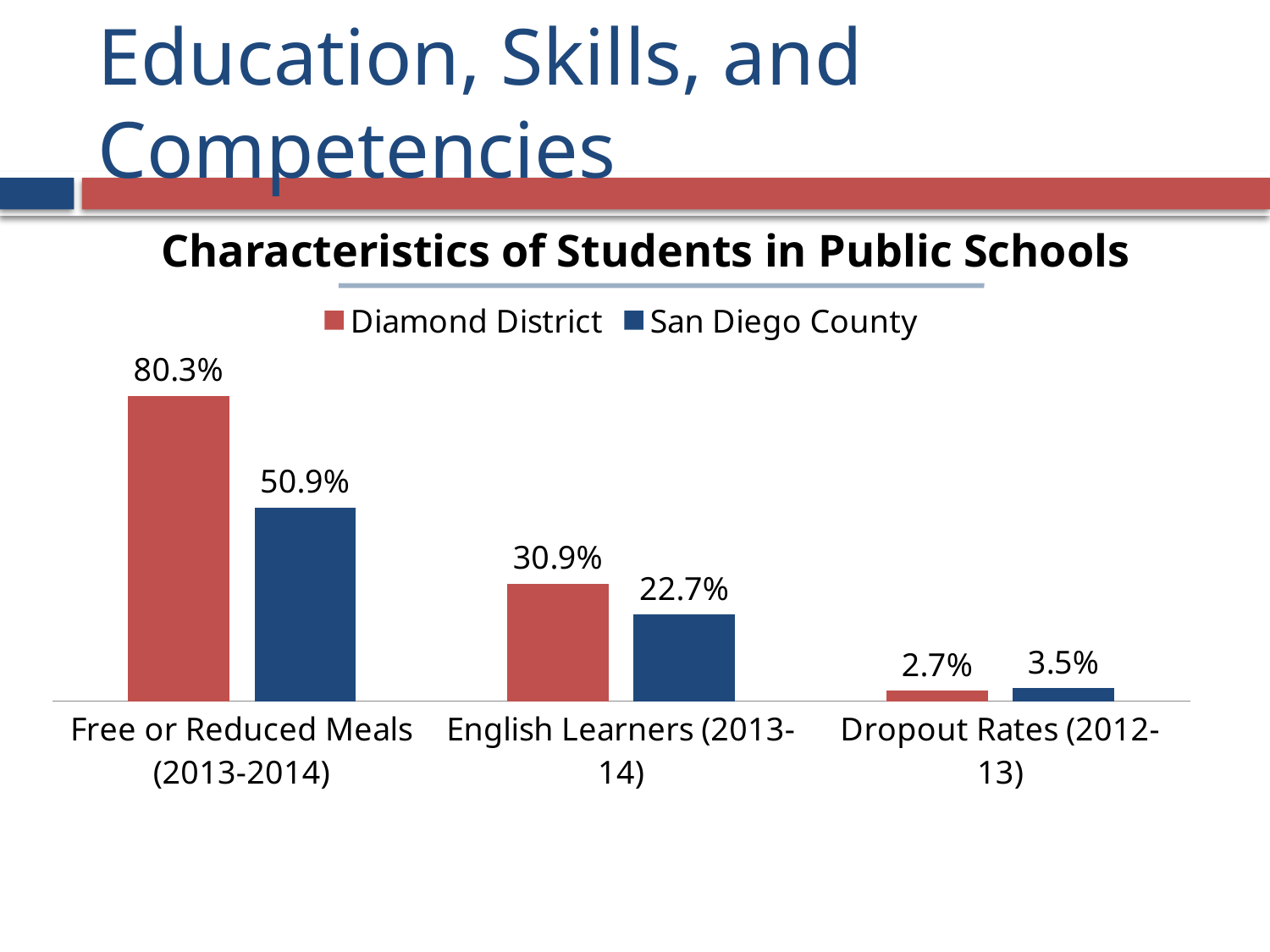
What is the San Diego County value for English Learners (2013-14)? 22.7% How many series does the legend list? 2 For Dropout Rates (2012-13), which series has the larger value, Diamond District or San Diego County? San Diego County What kind of chart is shown on the slide? Bar chart What is the San Diego County value for Free or Reduced Meals (2013-2014)? 50.9% What is the difference between the Diamond District and San Diego County values for English Learners (2013-14)? 8.2% Which category has the highest Diamond District value? Free or Reduced Meals (2013-2014) What is the Diamond District value for Free or Reduced Meals (2013-2014)? 80.3% What is the difference between the Diamond District and San Diego County values for Free or Reduced Meals (2013-2014)? 29.4% Which category has the lowest San Diego County value? Dropout Rates (2012-13) What is the Diamond District value for Dropout Rates (2012-13)? 2.7% How many categories are shown on the x axis? 3